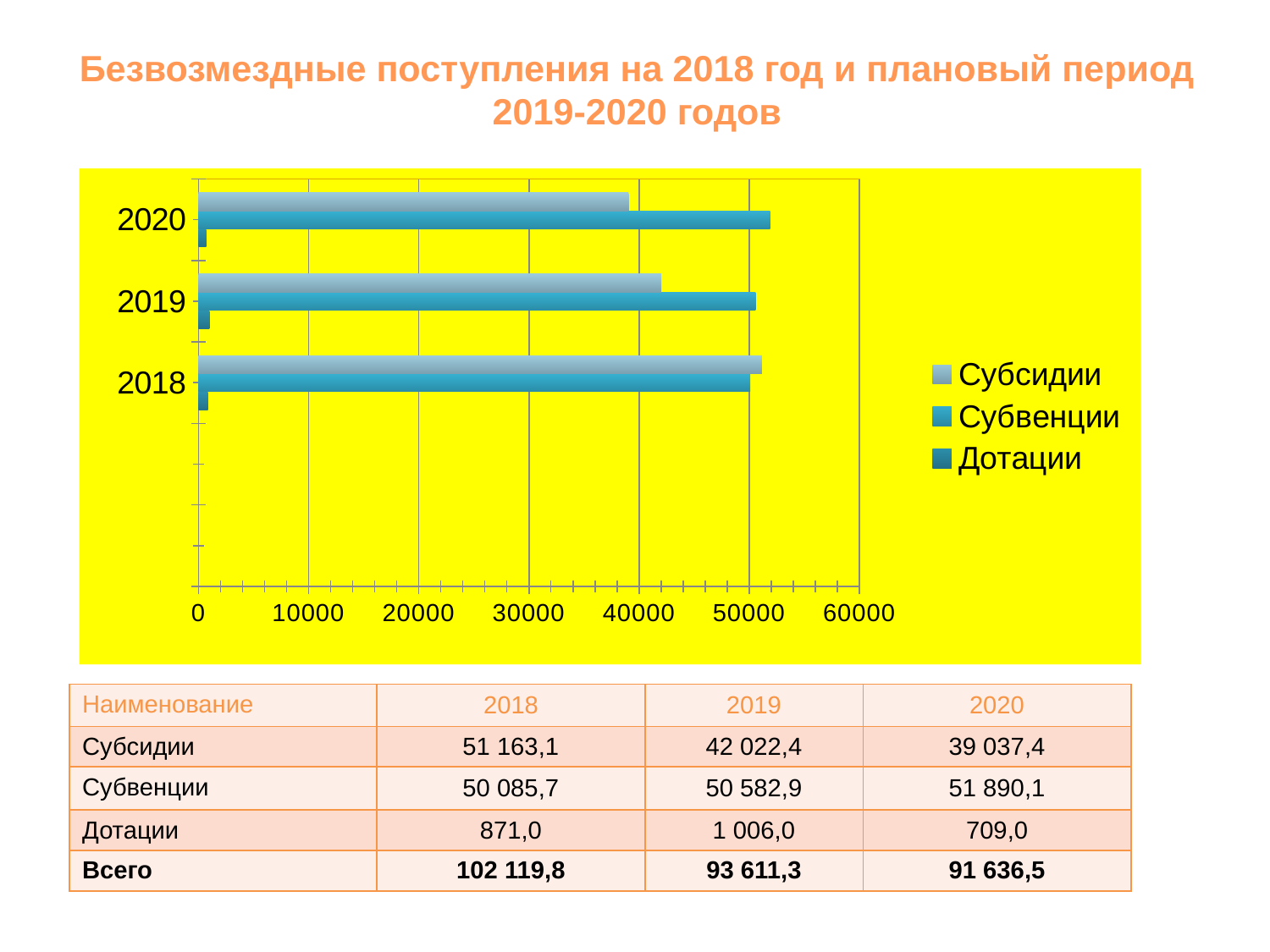
What is the value of Субсидии for 2018? 51 163,1 What is the value of Дотации for 2019? 1 006,0 Do the values of Субсидии rise or fall from 2018 to 2020? fall What is the difference between the Субвенции values for 2020 and 2019? 1 307,2 Which series is shown in the lightest blue colour in the legend? Субсидии In which year is the value of Субсидии the highest? 2018 For 2020, which is larger: Субсидии or Субвенции? Субвенции What kind of chart is shown on the slide? bar chart How many series does the chart legend list? 3 How many years (categories) are plotted on the chart? 3 Is the value of Субсидии for 2020 greater or less than 40000? less In which year is the value of Дотации the lowest? 2020